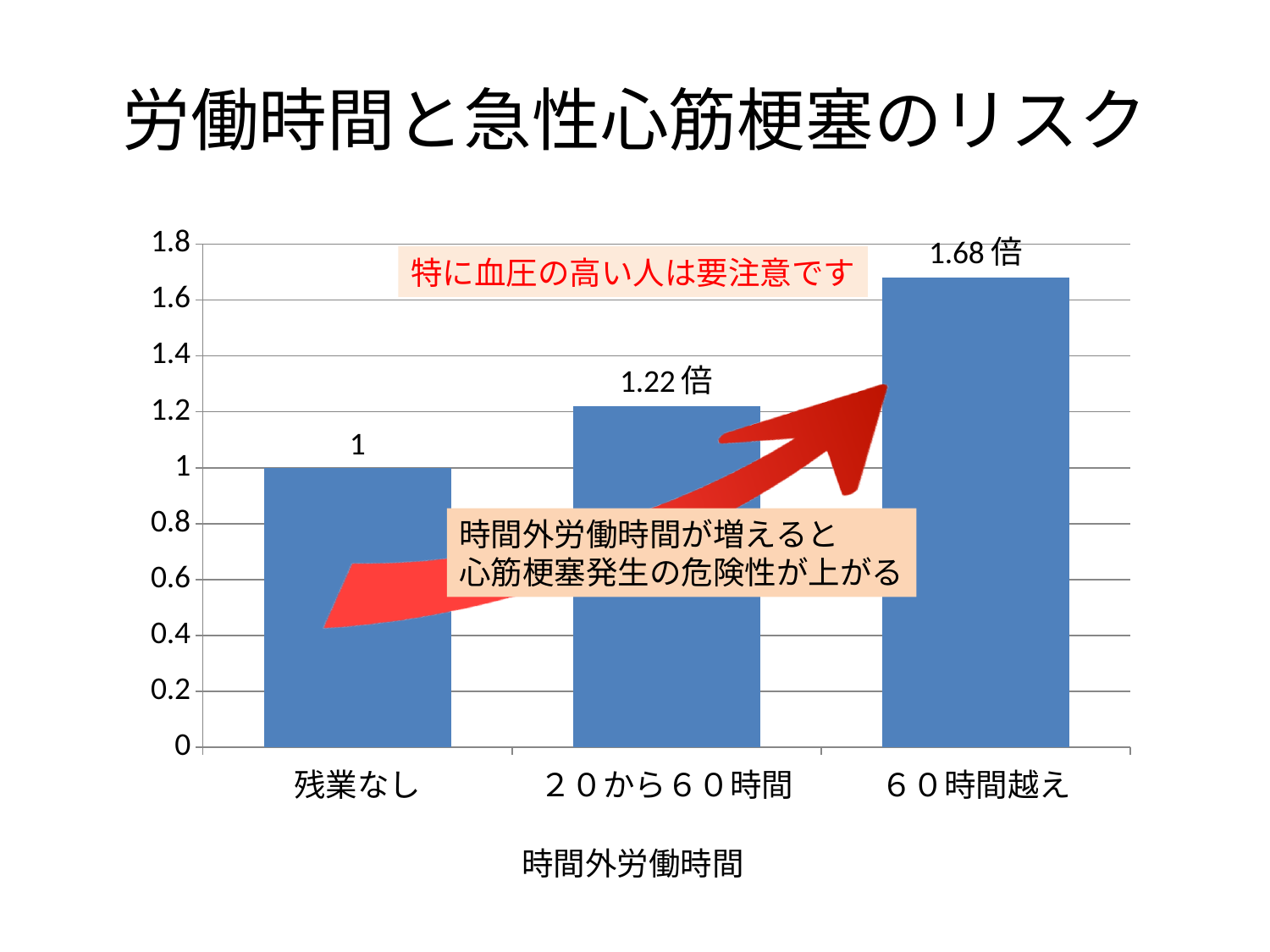
What kind of chart is shown on the slide? bar chart Which category has the highest value? ６０時間越え What is the value for ２０から６０時間? 1.22 倍 Is the value for ６０時間越え greater or less than 1.4? greater Which is larger, the value for ２０から６０時間 or the value for 残業なし? ２０から６０時間 Which category has the lowest value? 残業なし What is the value for ６０時間越え? 1.68 倍 What is the difference between the values for ６０時間越え and ２０から６０時間? 0.46 How many categories are shown on the x axis? 3 What is the value for 残業なし? 1 What is the difference between the values for ２０から６０時間 and 残業なし? 0.22 Do the values rise or fall from left to right along the x axis? rise